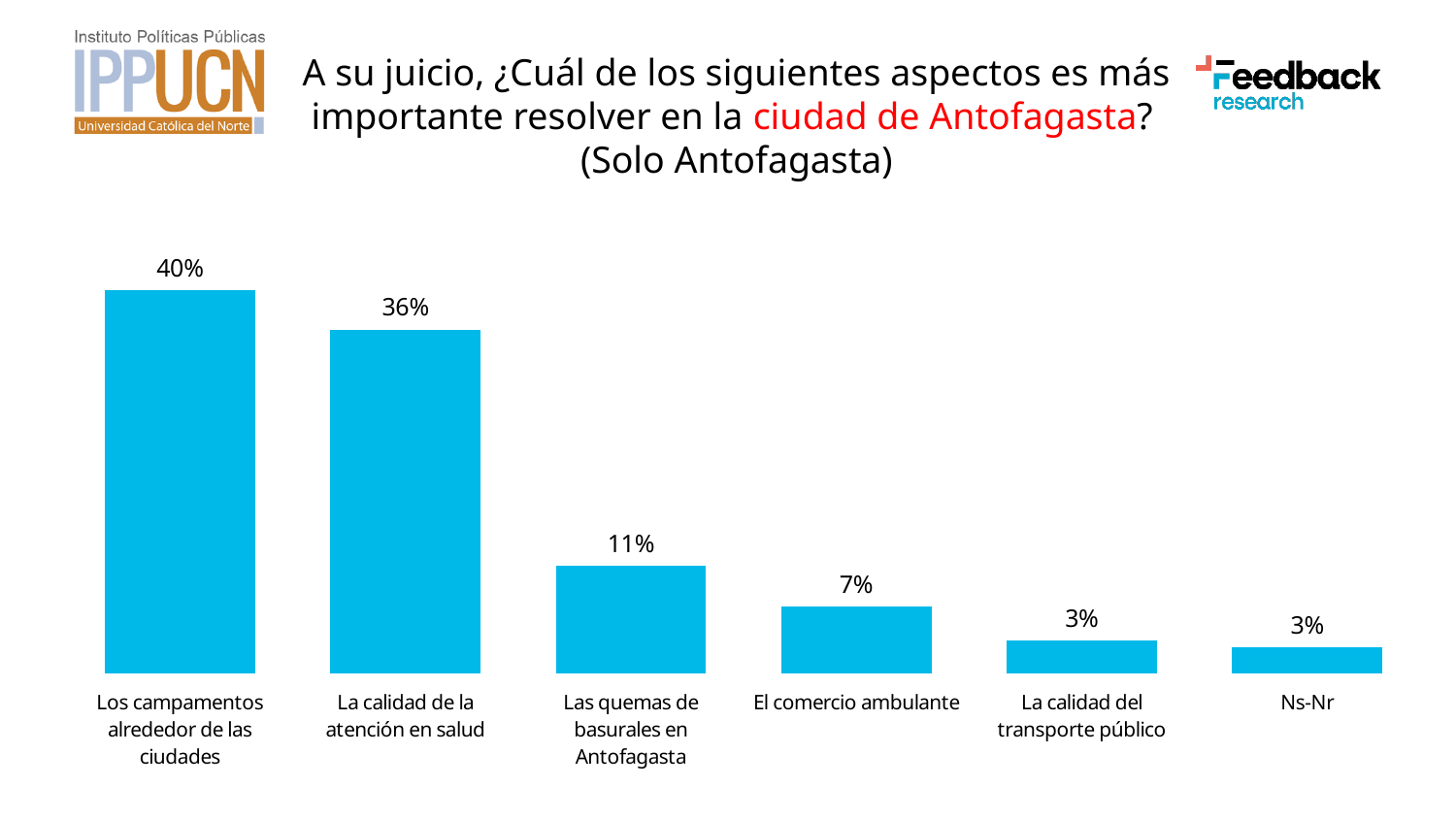
What is the difference between the values for "Los campamentos alrededor de las ciudades" and "La calidad de la atención en salud"? 4% Which is larger, the value for "El comercio ambulante" or the value for "La calidad del transporte público"? El comercio ambulante What is the value for "Los campamentos alrededor de las ciudades"? 40% What is the value for "La calidad de la atención en salud"? 36% Do the values rise or fall from left to right across the categories? Fall What is the value for "El comercio ambulante"? 7% How many categories are shown in the chart? 6 What is the difference between the values for "Las quemas de basurales en Antofagasta" and "El comercio ambulante"? 4% What kind of chart is shown on the slide? Bar chart What is the value for "Las quemas de basurales en Antofagasta"? 11% What is the value for "Ns-Nr"? 3% Which category has the highest value? Los campamentos alrededor de las ciudades